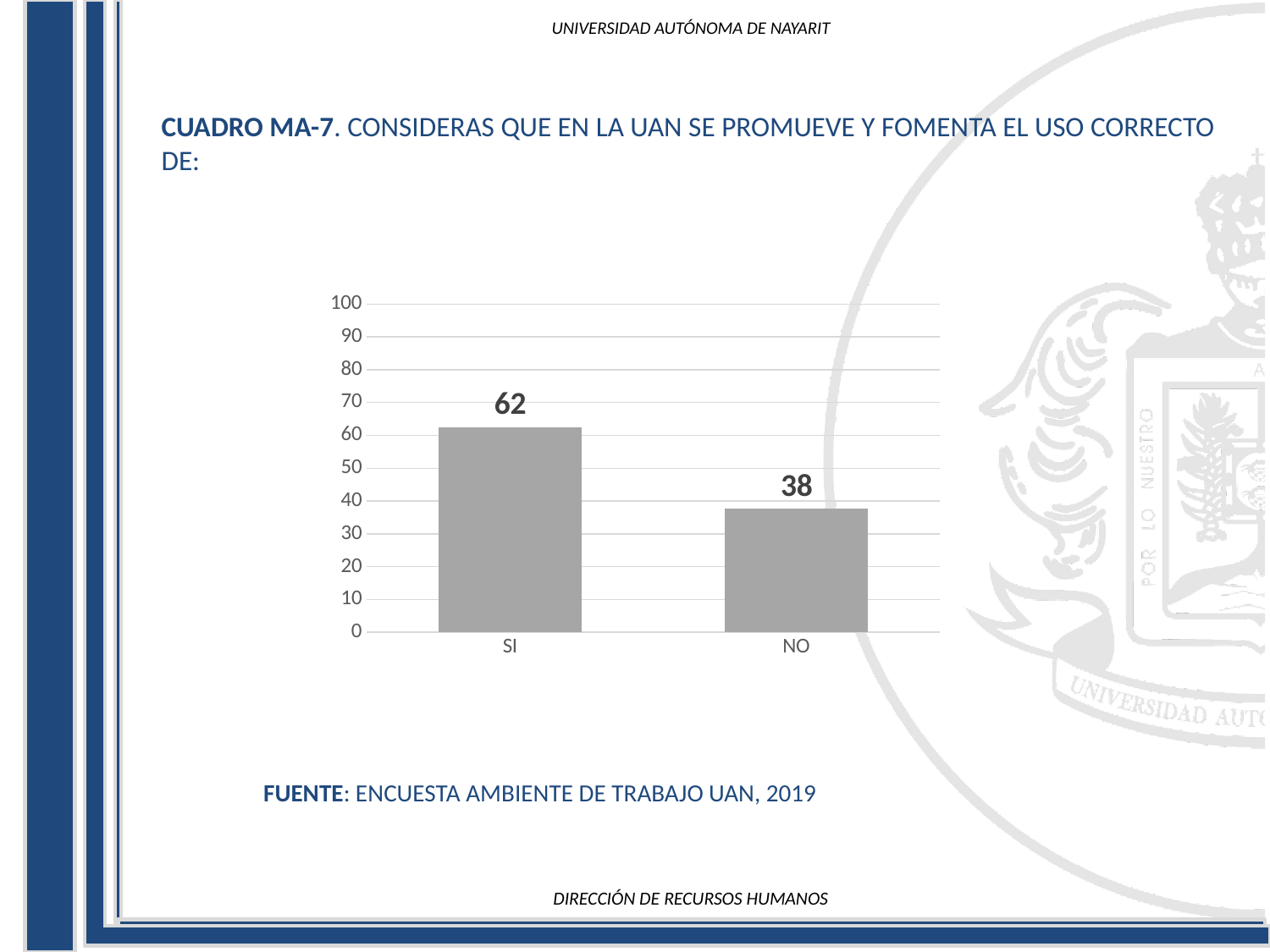
Which category has the highest value? SI Is the value for NO greater or less than 40? less What is the difference between the values for SI and NO? 24 Is the value for SI greater or less than 50? greater Which is larger, the value for SI or the value for NO? SI What is the maximum value shown on the y axis? 100 What is the total of the values for SI and NO? 100 What is the value for NO? 38 Which category has the lowest value? NO How many categories are shown on the x axis? 2 What kind of chart is shown on the slide? bar chart What is the value for SI? 62